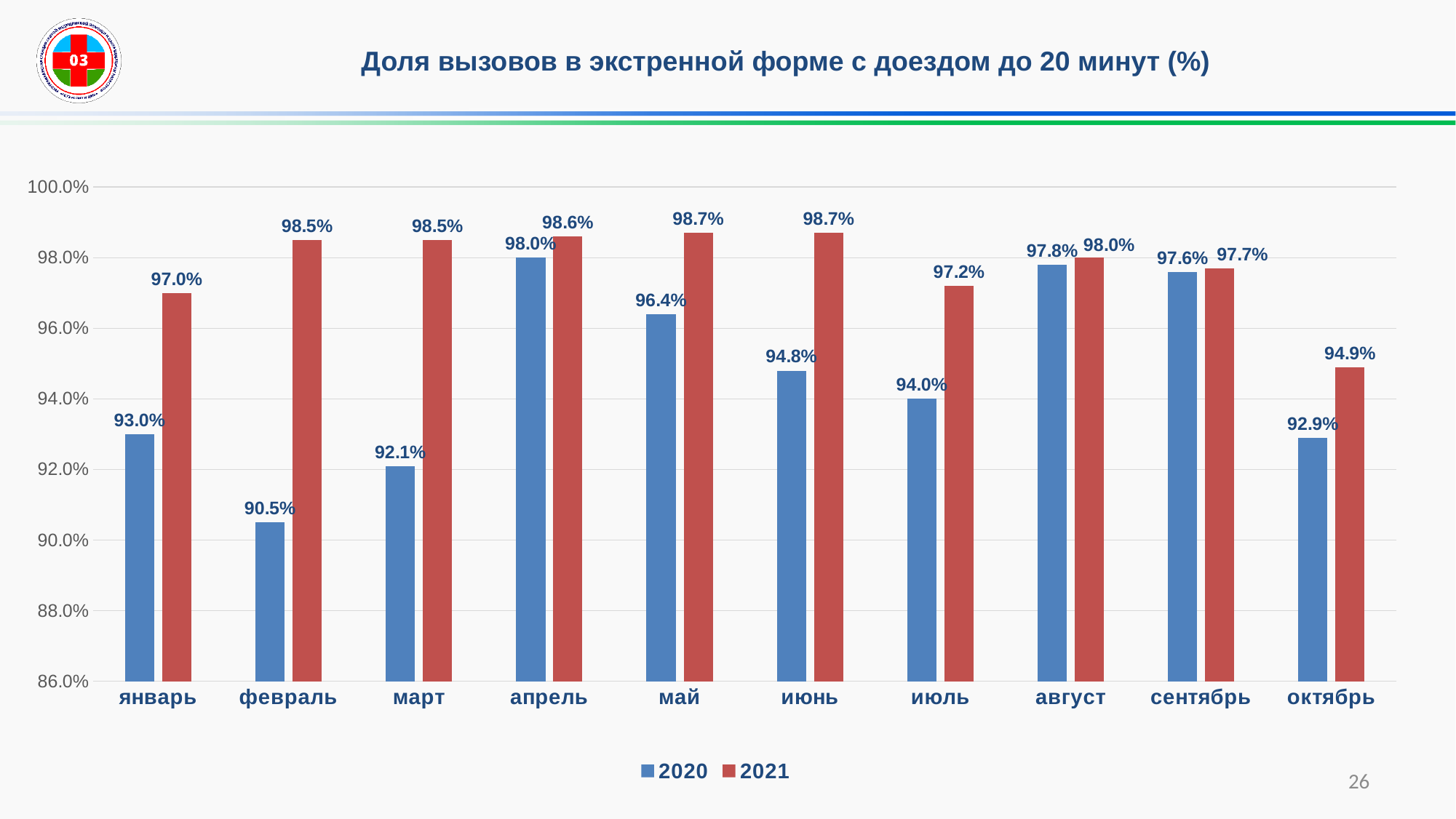
What is the title of the chart? Доля вызовов в экстренной форме с доездом до 20 минут (%) What is the value for 2021 in июль? 97.2% Which month has the lowest value for the 2021 series? октябрь How many series does the legend list? 2 Which month has the lowest value for the 2020 series? февраль Which is larger in май: the 2020 value or the 2021 value? 2021 What kind of chart is shown on the slide? Bar chart What is the value for 2020 in февраль? 90.5% What is the value for 2021 in октябрь? 94.9% How many months are shown on the x axis? 10 What is the difference between the 2021 and 2020 values in февраль? 8.0 percentage points Which month has the highest value for the 2020 series? апрель